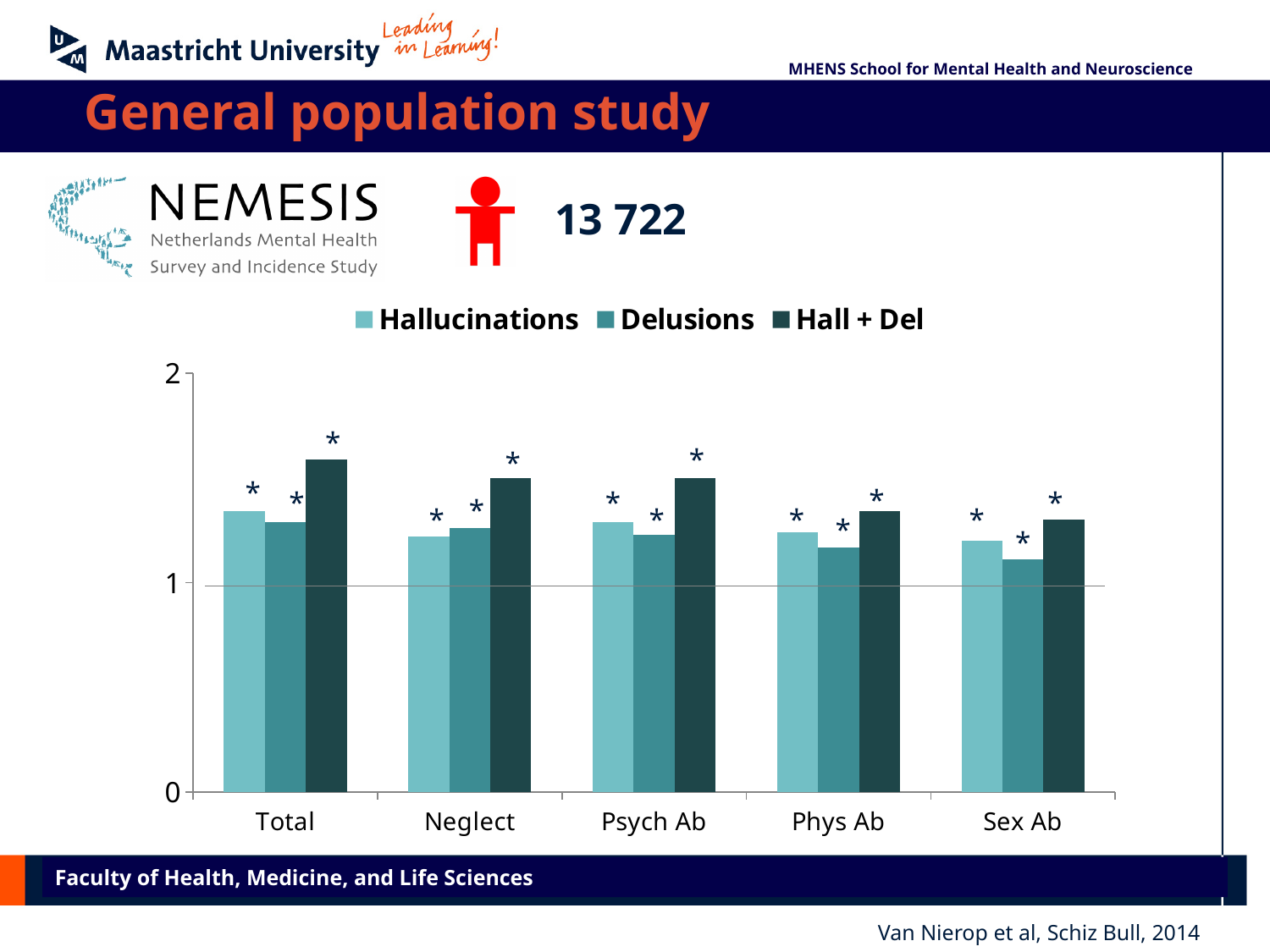
Is the Hallucinations value for Neglect greater or less than 1? greater What are the three series listed in the chart legend? Hallucinations, Delusions, Hall + Del Is the Hall + Del value for Total greater or less than 1? greater How many categories are shown on the x axis of the chart? 5 How many series does the chart legend list? 3 For Phys Ab, which is larger: the Delusions bar or the Hall + Del bar? Hall + Del What kind of chart is shown on the slide? bar chart Which bar is the lowest in the whole chart? Delusions for Sex Ab For Sex Ab, which is larger: the Hallucinations bar or the Delusions bar? Hallucinations For which category is the Hall + Del bar the tallest? Total Is the Delusions value for Sex Ab greater or less than 2? less Within the Total category, which series has the highest bar? Hall + Del